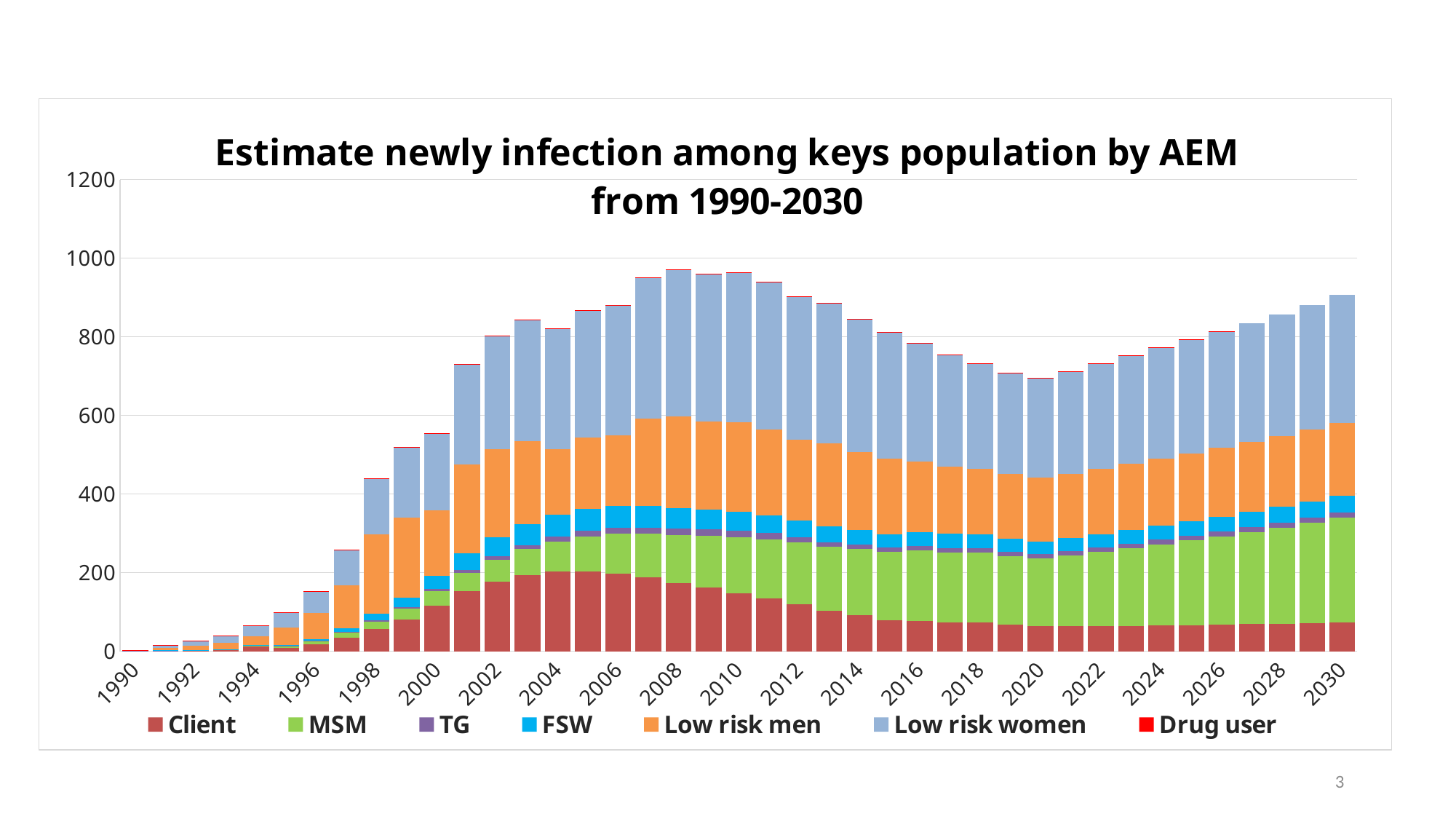
How many series does the legend list? 7 How many years (bars) are plotted along the x axis? 41 Is the total stacked value for 2008 greater or less than 800? greater Which series is shown in red in the legend? Drug user Is the total stacked value for 2020 greater or less than 800? less Is the total stacked value for 1998 greater or less than 600? less What is the title of the chart? Estimate newly infection among keys population by AEM from 1990-2030 Do the total estimated new infections rise or fall from 2020 to 2030? rise What kind of chart is shown on the slide? Stacked bar chart Which year has the lowest total of estimated new infections? 1990 Which year has the larger total of new infections, 2008 or 2020? 2008